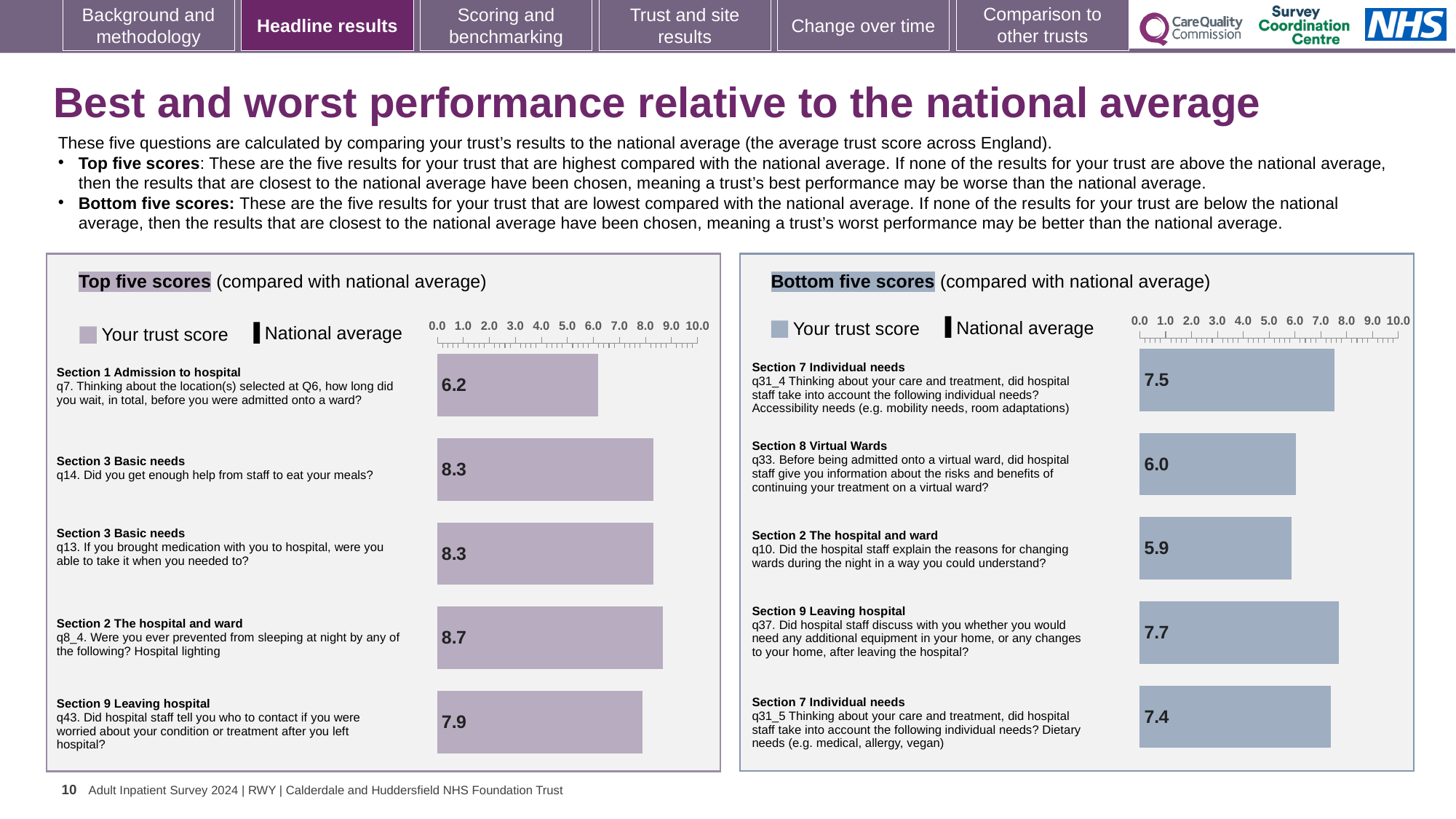
In the Bottom five scores chart, which question has the highest trust score? q37 (additional equipment or changes to your home after leaving hospital), 7.7 In the Bottom five scores chart, which question has the lowest trust score? q10 (explain the reasons for changing wards during the night), 5.9 In the Bottom five scores chart, what is the trust score for q33 (Before being admitted onto a virtual ward, did hospital staff give you information about the risks and benefits of continuing your treatment on a virtual ward?)? 6.0 In the Bottom five scores chart, which has the larger trust score: q31_4 (Accessibility needs) or q31_5 (Dietary needs)? q31_4 (Accessibility needs) What type of chart is used in the Top five scores panel? Bar chart In the Top five scores chart, which question has the highest trust score? q8_4 (Hospital lighting), 8.7 In the Top five scores chart, what is the difference between the trust score for q8_4 and the trust score for q7? 2.5 In the Top five scores chart, what is the trust score for q43 (Did hospital staff tell you who to contact if you were worried about your condition or treatment after you left hospital?)? 7.9 How many bars are plotted in the Bottom five scores chart? 5 In the Top five scores chart, what is the trust score for q14 (Did you get enough help from staff to eat your meals?)? 8.3 In the Top five scores chart, which question has the lowest trust score? q7 (how long did you wait before being admitted onto a ward), 6.2 In the Bottom five scores chart, what is the difference between the trust score for q37 and the trust score for q31_5? 0.3